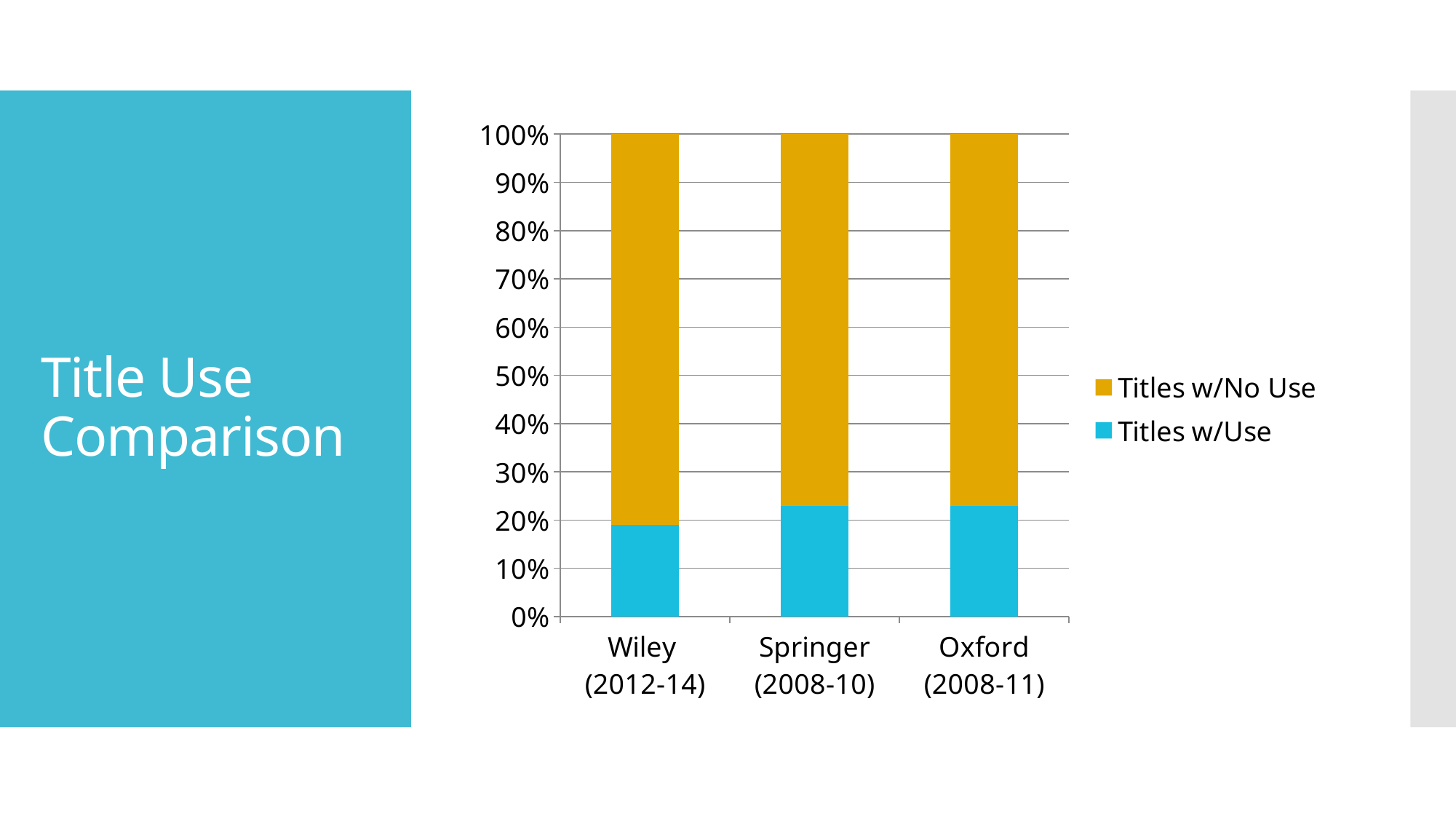
Which publisher has the lowest share of Titles w/Use? Wiley (2012-14) Which series is shown in blue in the legend? Titles w/Use Which publisher has the highest share of Titles w/No Use? Wiley (2012-14) Is the Titles w/Use value for Springer (2008-10) greater or less than 20%? greater What is the total height of each stacked bar? 100% How many publishers (categories) are shown on the x axis? 3 Is the Titles w/Use value for Oxford (2008-11) greater or less than 30%? less What kind of chart is shown on the slide? bar chart Which is larger for Titles w/Use: Wiley (2012-14) or Springer (2008-10)? Springer (2008-10) How many series does the legend list? 2